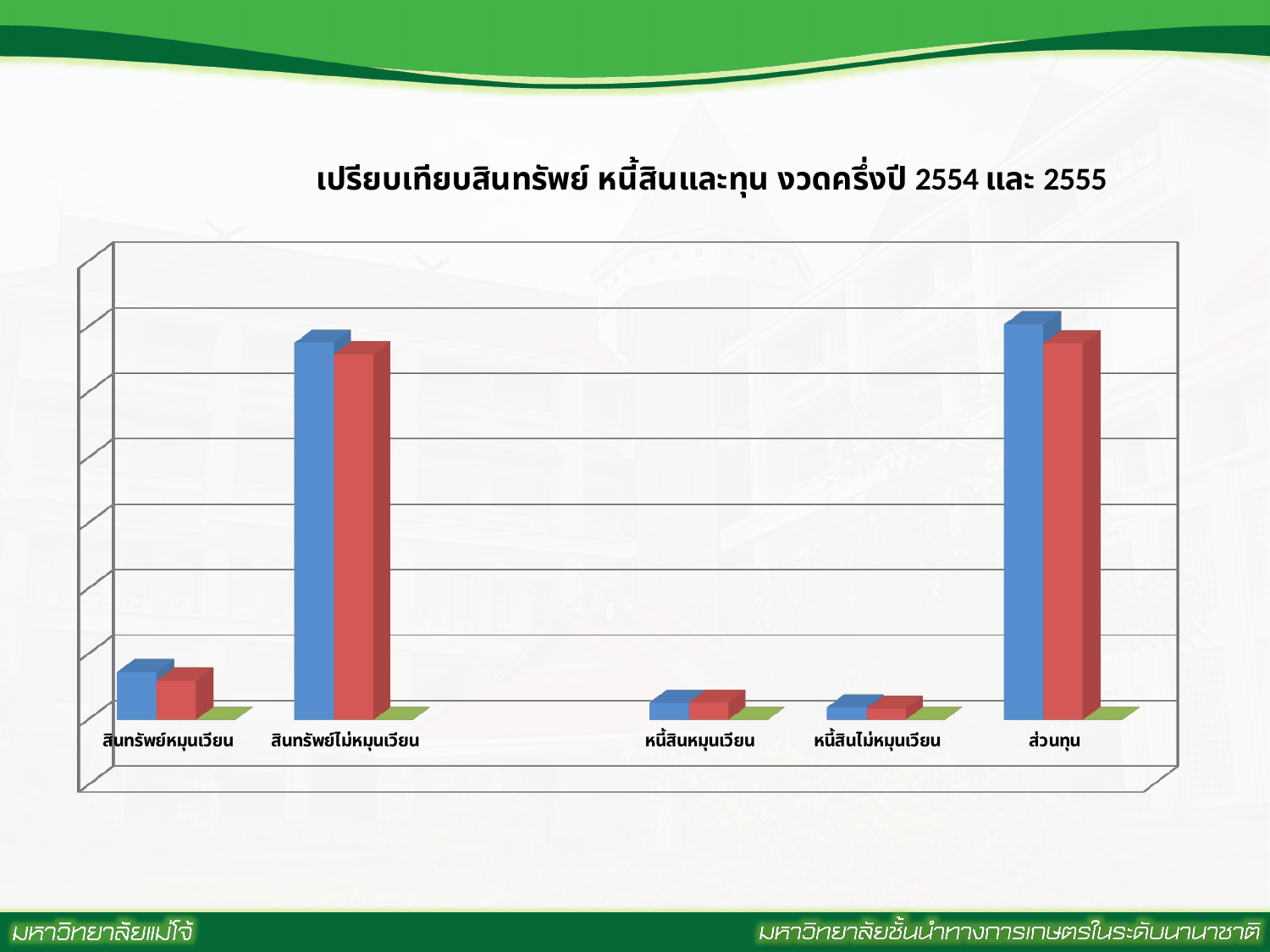
Which is larger, the blue bar for สินทรัพย์หมุนเวียน or the blue bar for หนี้สินหมุนเวียน? สินทรัพย์หมุนเวียน What two colours are used for the bars in the chart? blue and red How many categories are shown on the x axis of the chart? 5 Which category has the lowest bars in the chart? หนี้สินไม่หมุนเวียน For สินทรัพย์หมุนเวียน, which bar is taller, the blue one or the red one? the blue one Which is larger, the red bar for สินทรัพย์ไม่หมุนเวียน or the red bar for หนี้สินไม่หมุนเวียน? สินทรัพย์ไม่หมุนเวียน What is the title of the chart? เปรียบเทียบสินทรัพย์ หนี้สินและทุน งวดครึ่งปี 2554 และ 2555 What kind of chart is shown on the slide? bar chart Which category has the tallest blue bar in the chart? ส่วนทุน